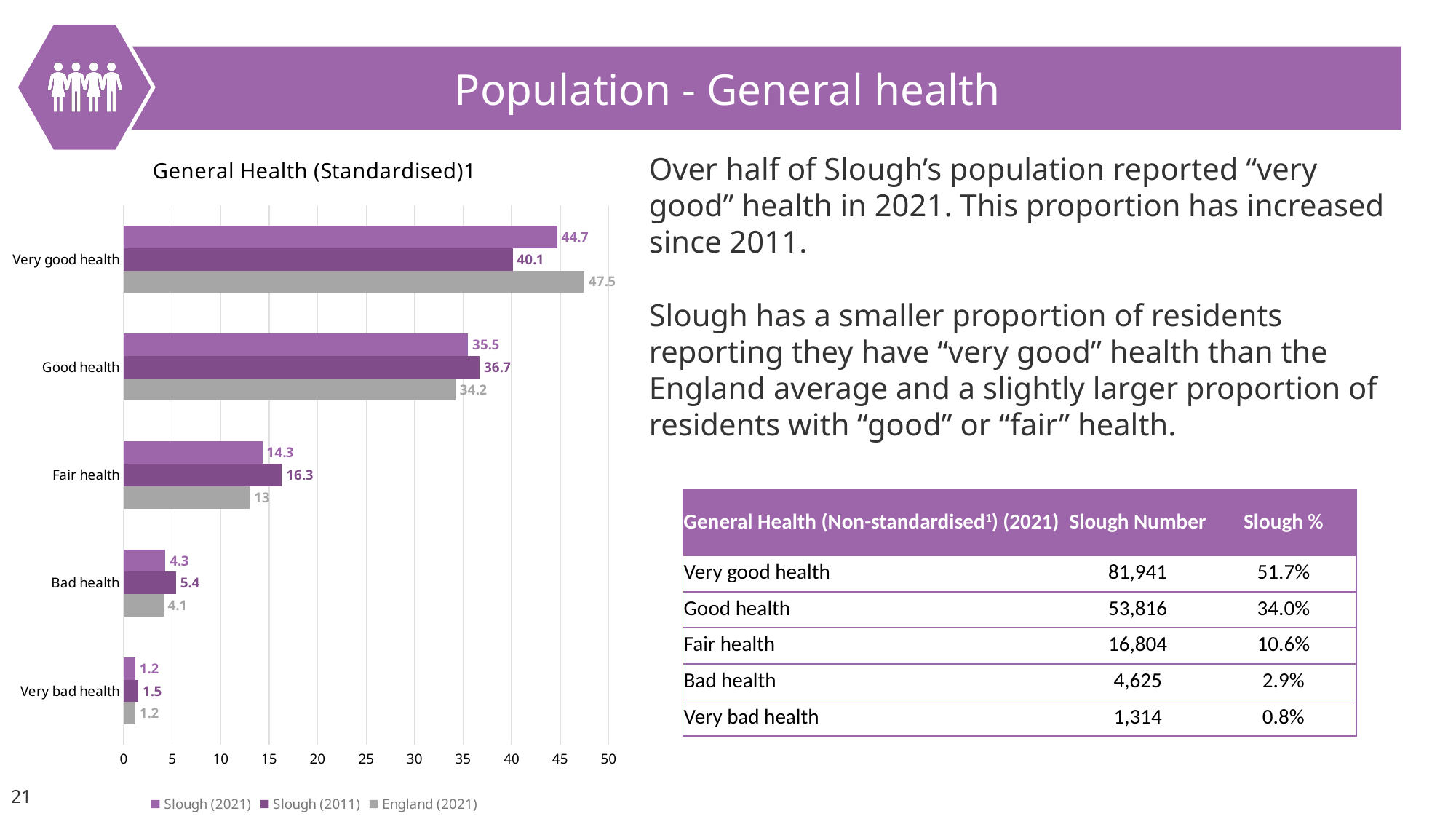
Which category has the highest Slough (2021) value? Very good health What is the Slough (2021) value for Very good health? 44.7 How many series does the legend list? 3 What is the Slough (2011) value for Fair health? 16.3 What is the difference between the England (2021) and Slough (2021) values for Very good health? 2.8 Which category has the lowest England (2021) value? Very bad health What kind of chart is shown on the slide? Bar chart Which is larger for Bad health: Slough (2021) or Slough (2011)? Slough (2011) Is the Slough (2011) value for Very good health greater or less than 35? greater How many health categories are shown on the chart? 5 What is the England (2021) value for Good health? 34.2 What is the title of the chart? General Health (Standardised)1